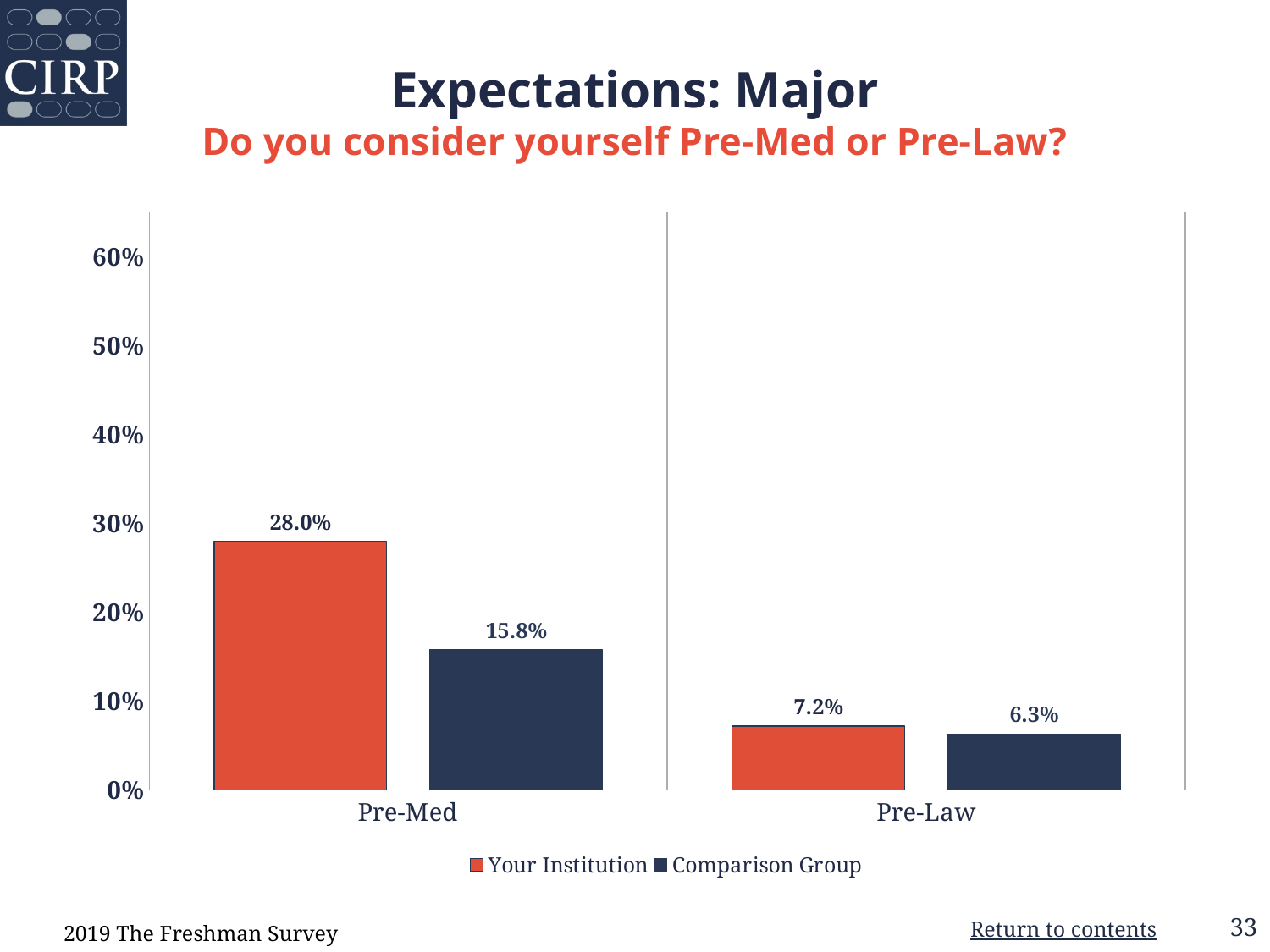
What is the difference between Your Institution and Comparison Group for Pre-Med? 12.2% What is the value for Comparison Group for Pre-Law? 6.3% What kind of chart is shown on the slide? bar chart Which category has the highest value for Your Institution? Pre-Med For Pre-Law, which is larger: Your Institution or Comparison Group? Your Institution Which category has the lowest value for Comparison Group? Pre-Law What is the value for Your Institution for Pre-Med? 28.0% How many series does the legend list? 2 What is the value for Comparison Group for Pre-Med? 15.8% What is the value for Your Institution for Pre-Law? 7.2% Is the value for Your Institution for Pre-Med greater or less than 20%? greater How many categories are shown on the x axis? 2